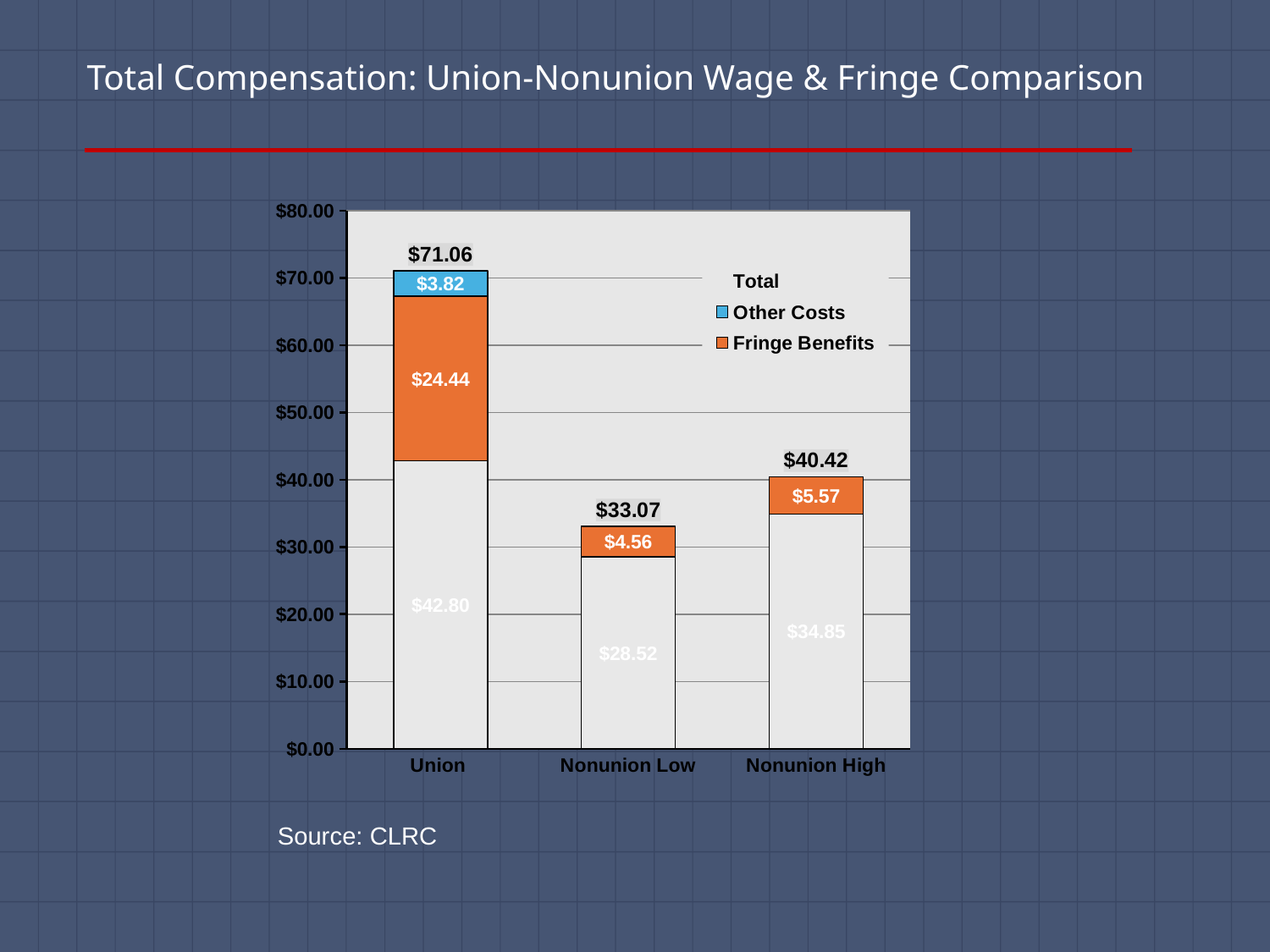
What is the Fringe Benefits value for Nonunion High? $5.57 What is the Fringe Benefits value for Nonunion Low? $4.56 Which has the larger Fringe Benefits value, Union or Nonunion Low? Union What source is cited below the chart? CLRC Is the total for Nonunion Low greater or less than $40.00? less Which category has the lowest total compensation? Nonunion Low What is the difference between the Union total ($71.06) and the Nonunion High total ($40.42)? $30.64 How many categories are shown on the x axis of the chart? 3 Which category has the highest total compensation? Union What kind of chart is shown on the slide? Stacked bar chart What is the total compensation value shown for Union? $71.06 What is the Other Costs value for Union? $3.82